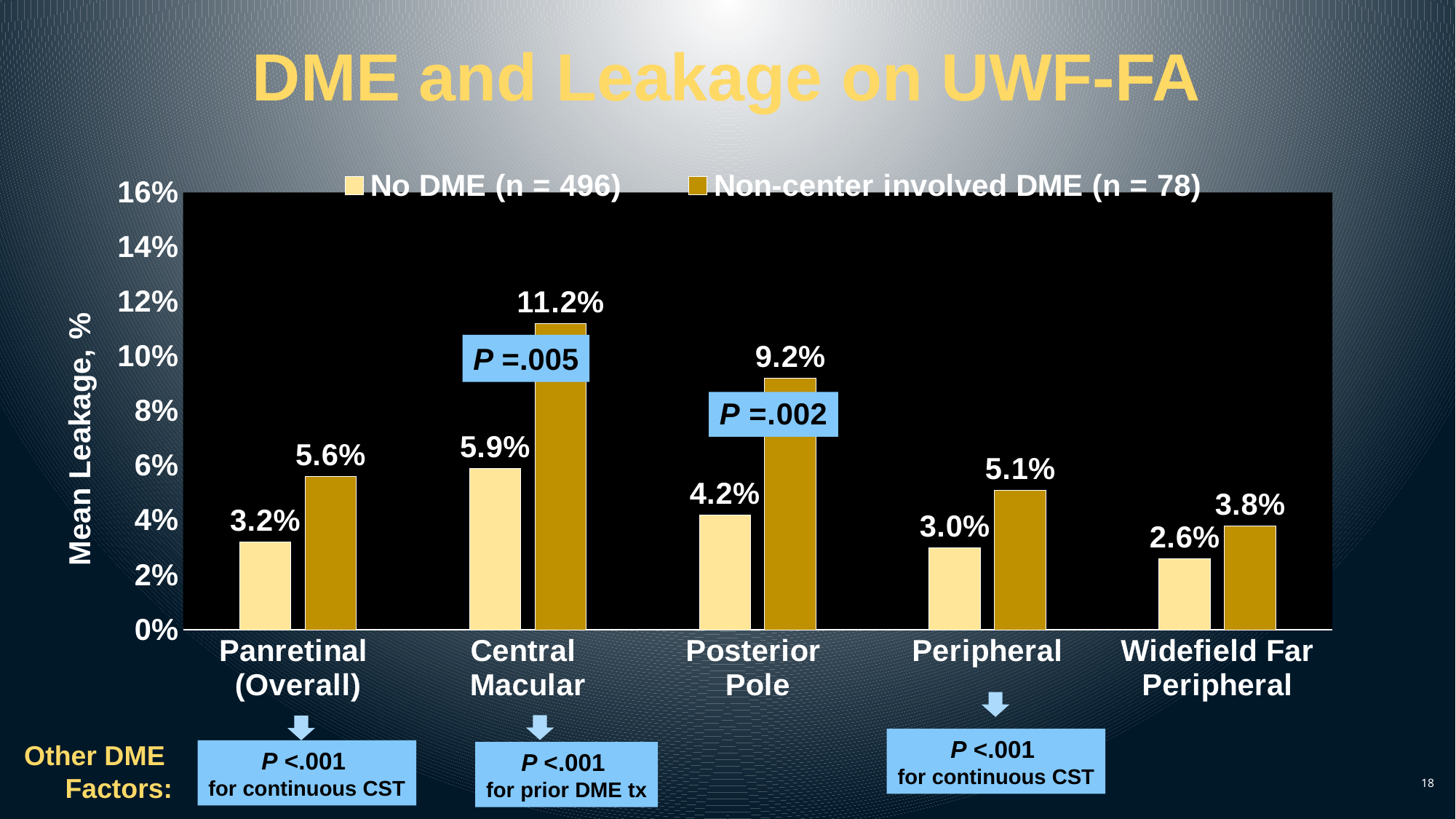
How many series does the legend list? 2 What is the difference between the Non-center involved DME and No DME values for the Central Macular region? 5.3% How many regions are shown on the x axis? 5 Which region has the highest mean leakage for the Non-center involved DME group? Central Macular Is the Non-center involved DME value for Central Macular greater or less than 10%? greater What is the mean leakage for the No DME group in the Widefield Far Peripheral region? 2.6% What type of chart is shown on the slide? Bar chart Which region has the lowest mean leakage for the No DME group? Widefield Far Peripheral What is the difference between the Non-center involved DME and No DME values for the Panretinal (Overall) region? 2.4% What is the mean leakage for the Non-center involved DME group in the Posterior Pole region? 9.2% What is the mean leakage for the No DME group in the Central Macular region? 5.9% Which is larger: the No DME value for Posterior Pole or the No DME value for Peripheral? Posterior Pole